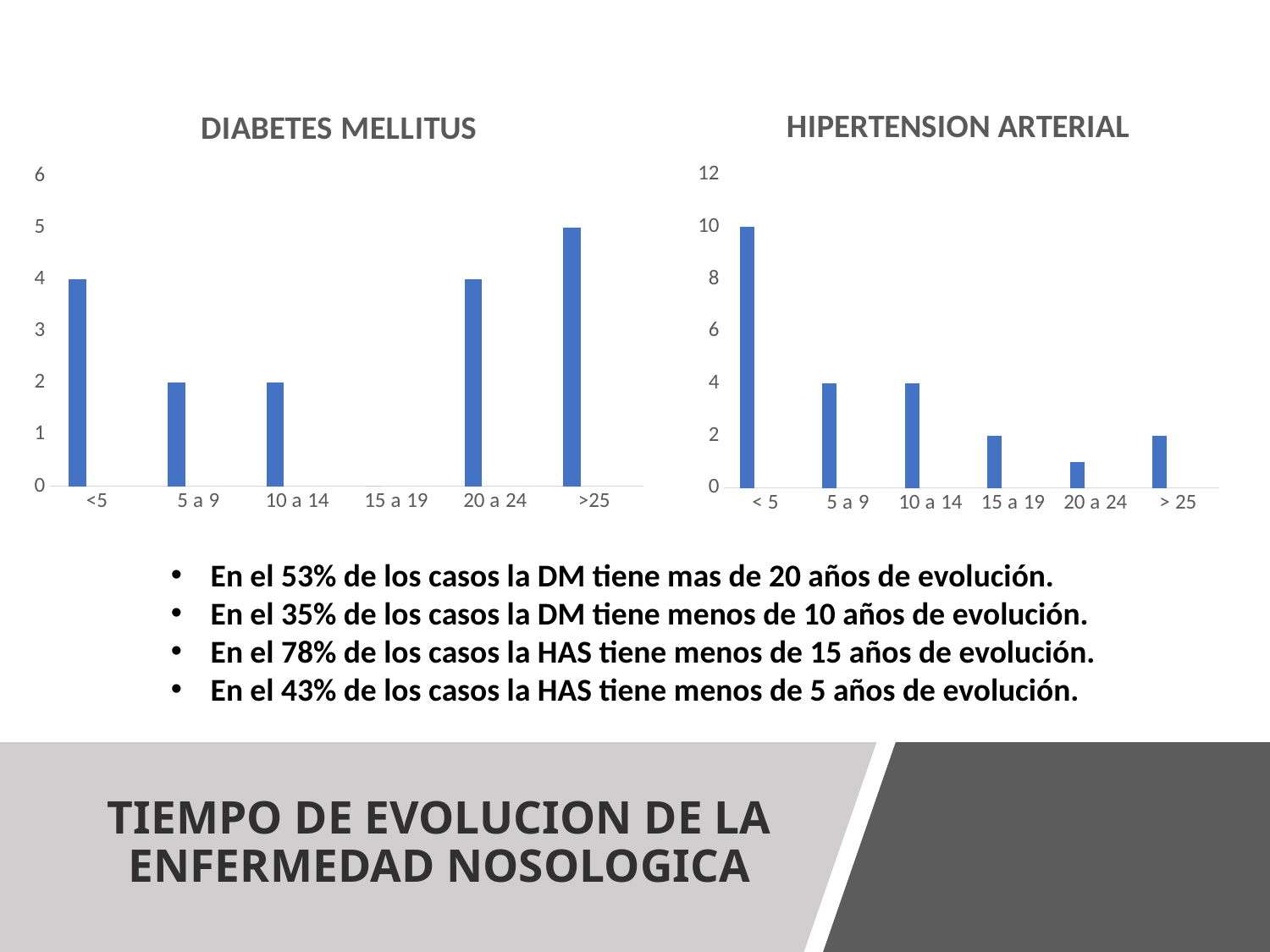
In the DIABETES MELLITUS chart, which category has the highest value? >25 In the DIABETES MELLITUS chart, what is the value for the >25 category? 5 In the DIABETES MELLITUS chart, what is the value for the <5 category? 4 In the DIABETES MELLITUS chart, what is the difference between the >25 value and the 5 a 9 value? 3 In the HIPERTENSION ARTERIAL chart, which category has the lowest value? 20 a 24 In the DIABETES MELLITUS chart, how many categories are shown on the x axis? 6 In the HIPERTENSION ARTERIAL chart, is the value for 20 a 24 greater or less than 2? less What kind of chart is the HIPERTENSION ARTERIAL chart? Bar chart In the HIPERTENSION ARTERIAL chart, which category has the highest value? < 5 In the HIPERTENSION ARTERIAL chart, which is larger, the value for < 5 or the value for 5 a 9? < 5 In the HIPERTENSION ARTERIAL chart, what is the value for the 15 a 19 category? 2 In the HIPERTENSION ARTERIAL chart, what is the value for the < 5 category? 10